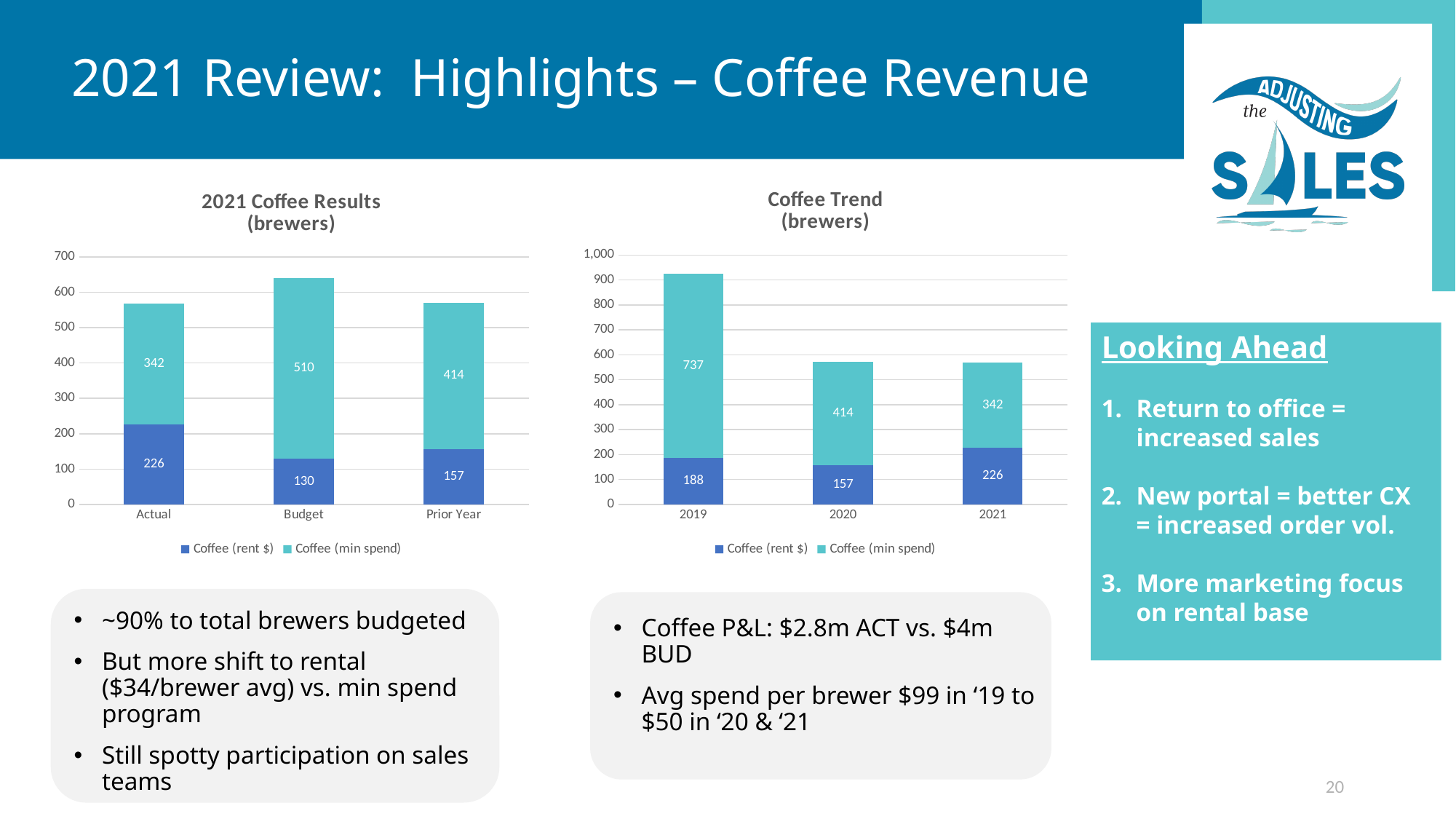
In the 2021 Coffee Results (brewers) chart, which category has the lowest Coffee (rent $) value? Budget What kind of chart is the 2021 Coffee Results (brewers) chart? stacked bar chart In the Coffee Trend (brewers) chart, what is the Coffee (rent $) value for 2020? 157 In the 2021 Coffee Results (brewers) chart, what is the Coffee (rent $) value for Actual? 226 In the Coffee Trend (brewers) chart, is the Coffee (rent $) value for 2021 larger or smaller than the value for 2019? larger In the 2021 Coffee Results (brewers) chart, what is the Coffee (min spend) value for Budget? 510 In the Coffee Trend (brewers) chart, what is the Coffee (min spend) value for 2019? 737 In the Coffee Trend (brewers) chart, what is the difference between the Coffee (min spend) values for 2019 and 2020? 323 In the 2021 Coffee Results (brewers) chart, which category has the highest Coffee (min spend) value? Budget In the 2021 Coffee Results (brewers) chart, what is the total of the stacked bar for Budget? 640 In the Coffee Trend (brewers) chart, what is the total of the stacked bar for 2019? 925 How many series does the legend of the Coffee Trend (brewers) chart list? 2